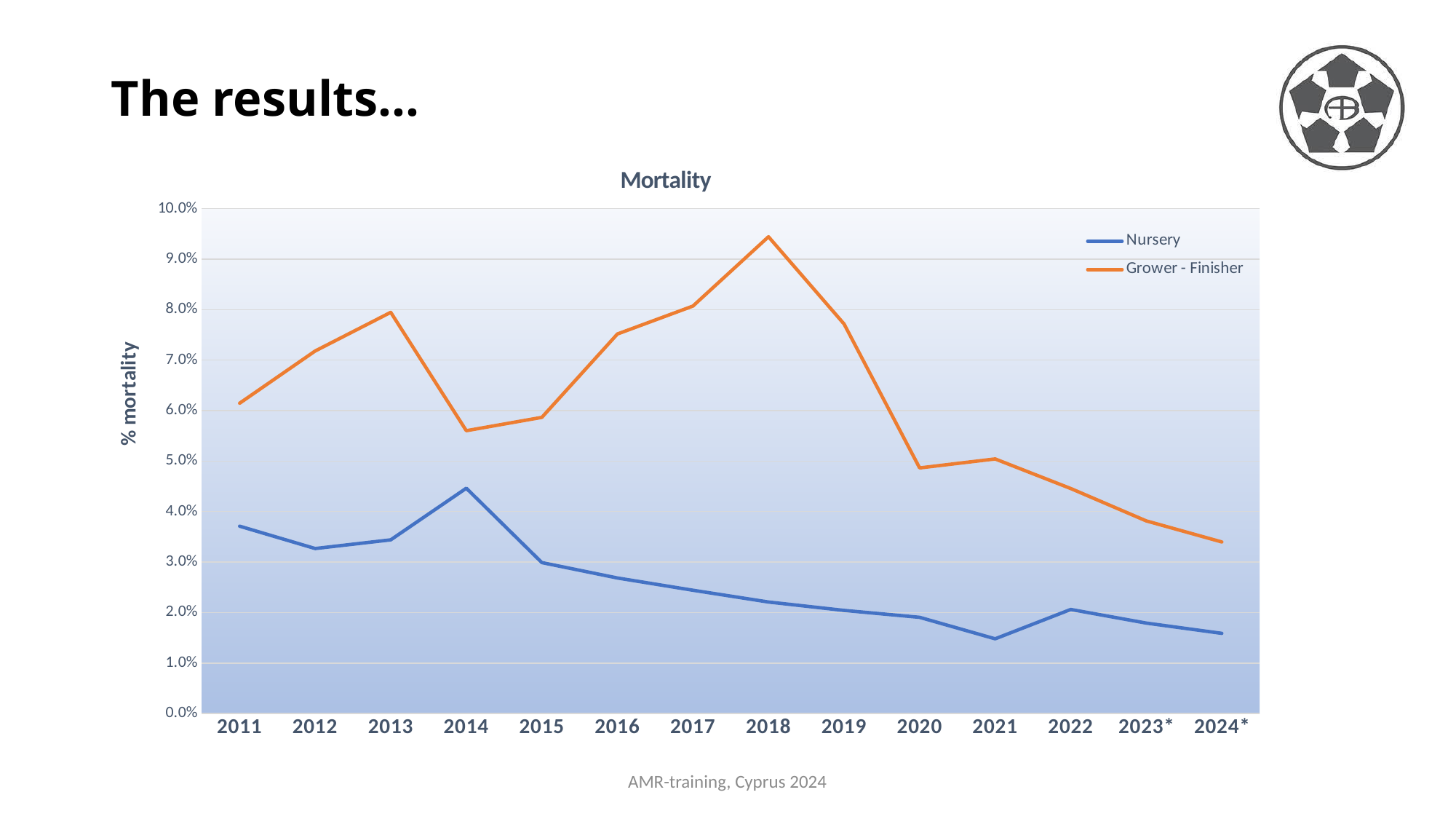
What kind of chart is shown on the slide? Line chart In which year does the Grower - Finisher series reach its lowest value? 2024* In which year does the Grower - Finisher series reach its highest value? 2018 How many series does the legend of the Mortality chart list? 2 Is the Grower - Finisher value for 2014 greater or less than 6.0%? less Which is larger, the Nursery value for 2011 or the Nursery value for 2015? 2011 What is the label on the y axis of the chart? % mortality Is the Grower - Finisher value for 2018 greater or less than 9.0%? greater Is the Nursery value for 2014 greater or less than 4.0%? greater How many years are plotted along the x axis of the Mortality chart? 14 Does the Nursery series rise or fall overall from 2011 to 2024*? Fall In which year does the Nursery series reach its highest value? 2014